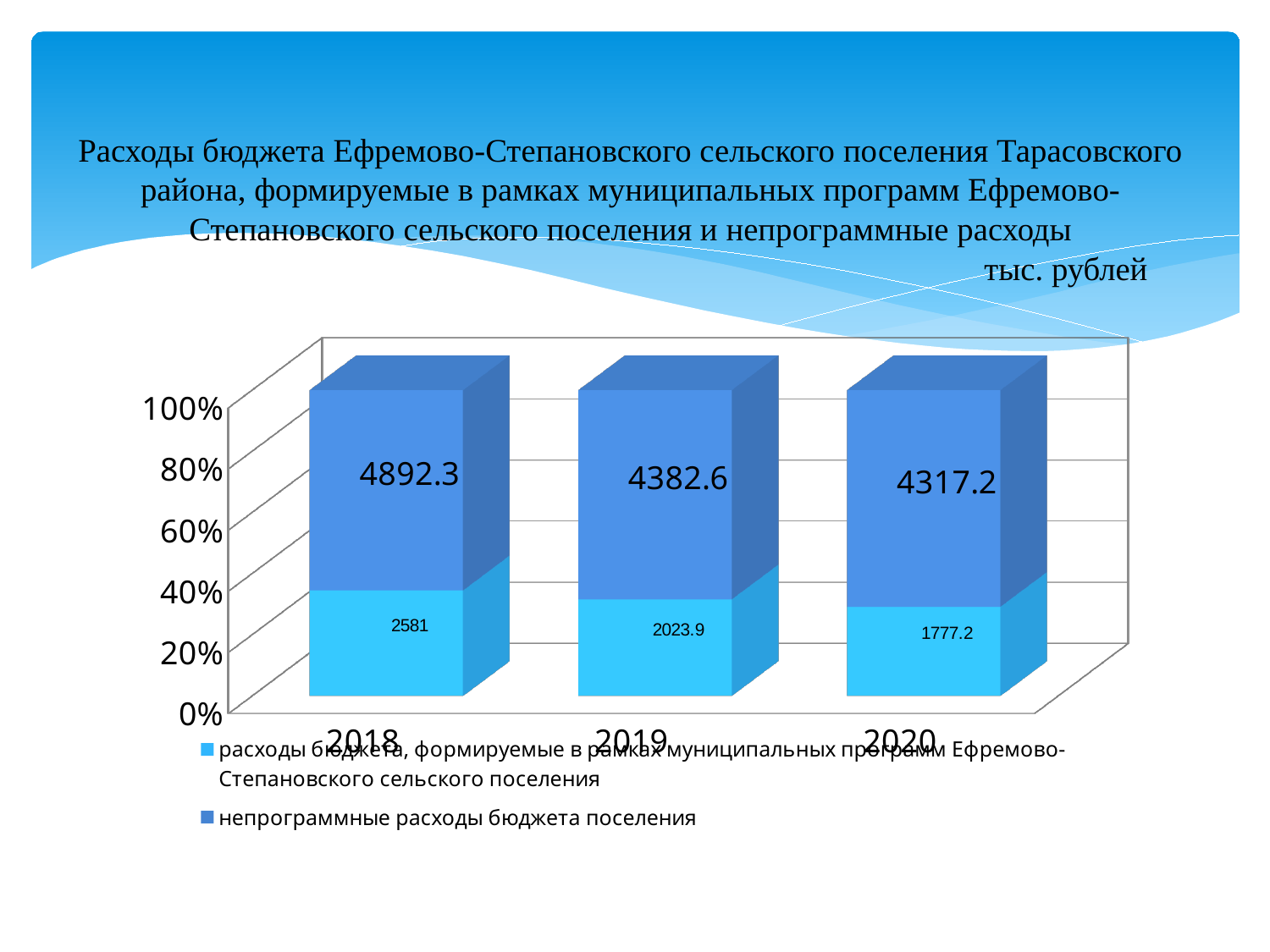
What is the value of непрограммные расходы бюджета поселения for 2018? 4892.3 What is the total of the two series for 2019? 6406.5 How many years are shown on the x axis? 3 In which year is the value of непрограммные расходы бюджета поселения the lowest? 2020 What kind of chart is shown on the slide? stacked bar chart What is the value of расходы бюджета, формируемые в рамках муниципальных программ for 2019? 2023.9 How many series does the legend list? 2 What is the difference between непрограммные расходы and программные расходы in 2018? 2311.3 In which year is the value of расходы бюджета, формируемые в рамках муниципальных программ the highest? 2018 By how much did расходы бюджета, формируемые в рамках муниципальных программ decrease from 2018 to 2020? 803.8 Which is larger in 2019: непрограммные расходы бюджета поселения or расходы в рамках муниципальных программ? непрограммные расходы бюджета поселения What is the value of расходы бюджета, формируемые в рамках муниципальных программ for 2020? 1777.2